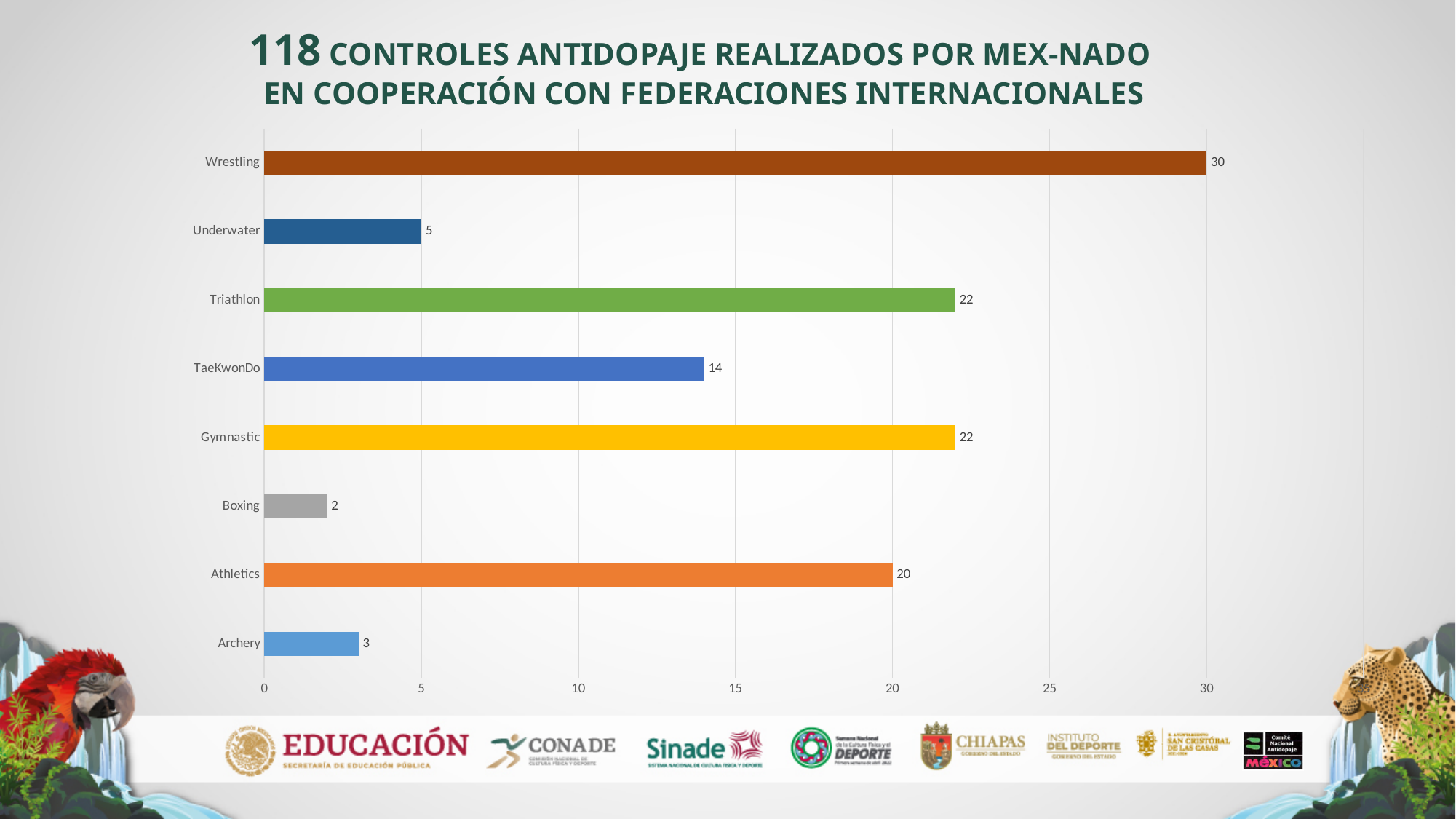
What is the value for TaeKwonDo? 14 What is the value for Wrestling? 30 Which is larger, the value for Underwater or the value for Archery? Underwater Which category has the lowest value? Boxing What kind of chart is shown on the slide? bar chart How many categories are shown in the chart? 8 What is the value for Athletics? 20 Is the value for Gymnastic greater or less than 20? greater What is the highest value shown on the horizontal axis? 30 Which category has the highest value? Wrestling What is the total of the values for Boxing and Archery? 5 What is the difference between the values for Wrestling and Triathlon? 8